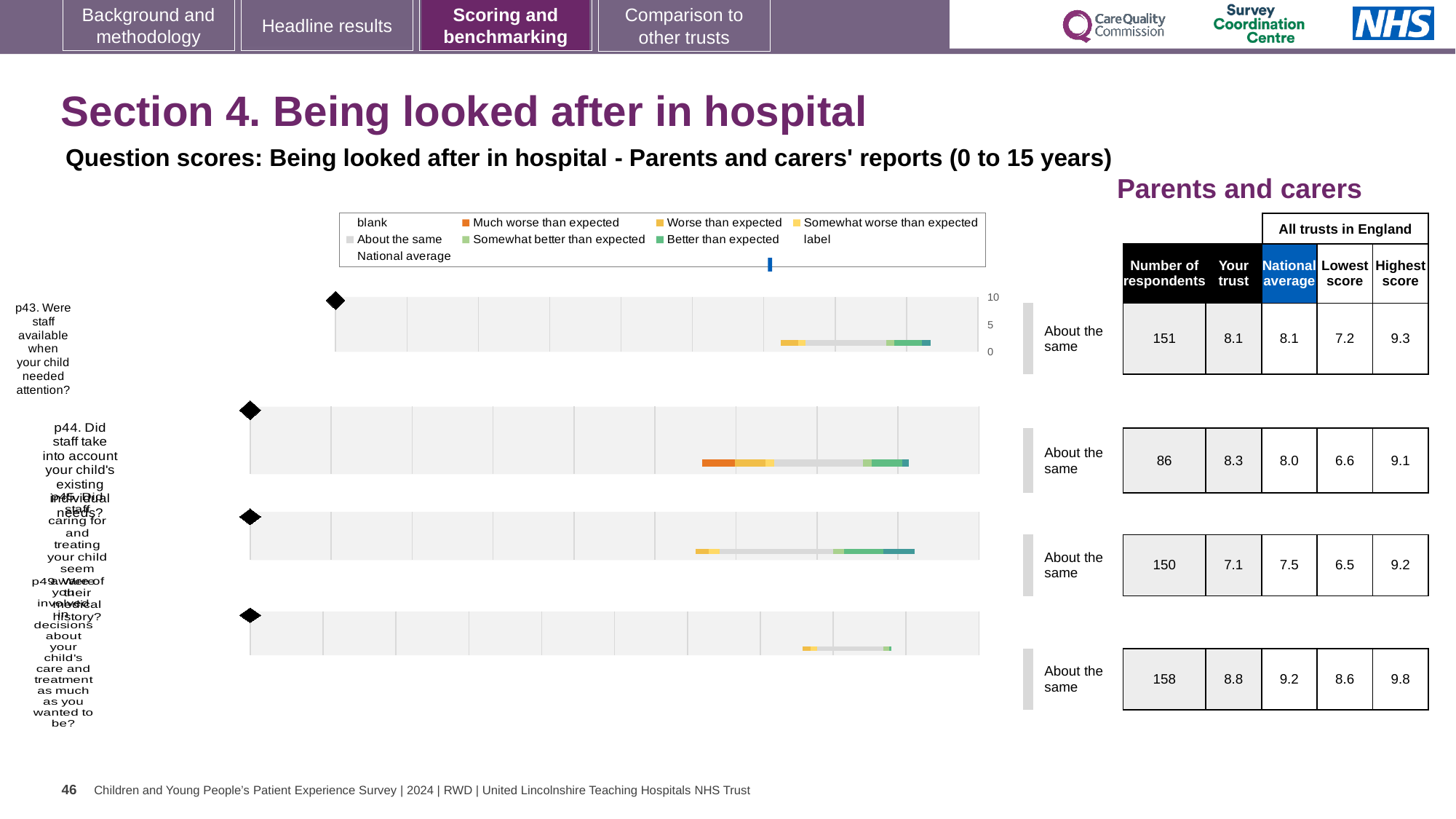
What kind of chart is used for each question row on the slide? bar chart What benchmark category is shown next to every question row? About the same For p44, what is the difference between the 'Your trust' score and the national average? 0.3 Which question row has the highest 'Your trust' score? the fourth (bottom) row, 8.8 For p43, how many respondents are listed? 151 Which question row has the lowest 'Your trust' score? the third row, 7.1 What is the highest score across all trusts in England for the fourth (bottom) question row? 9.8 For p43 (Were staff available when your child needed attention?), what is the 'Your trust' score? 8.1 How many question rows (charts) are shown on the slide? 4 For p44, which is larger: the 'Your trust' score or the national average? Your trust For p44, what is the national average score? 8.0 For p44 (Did staff take into account your child's existing individual needs?), what is the 'Your trust' score? 8.3